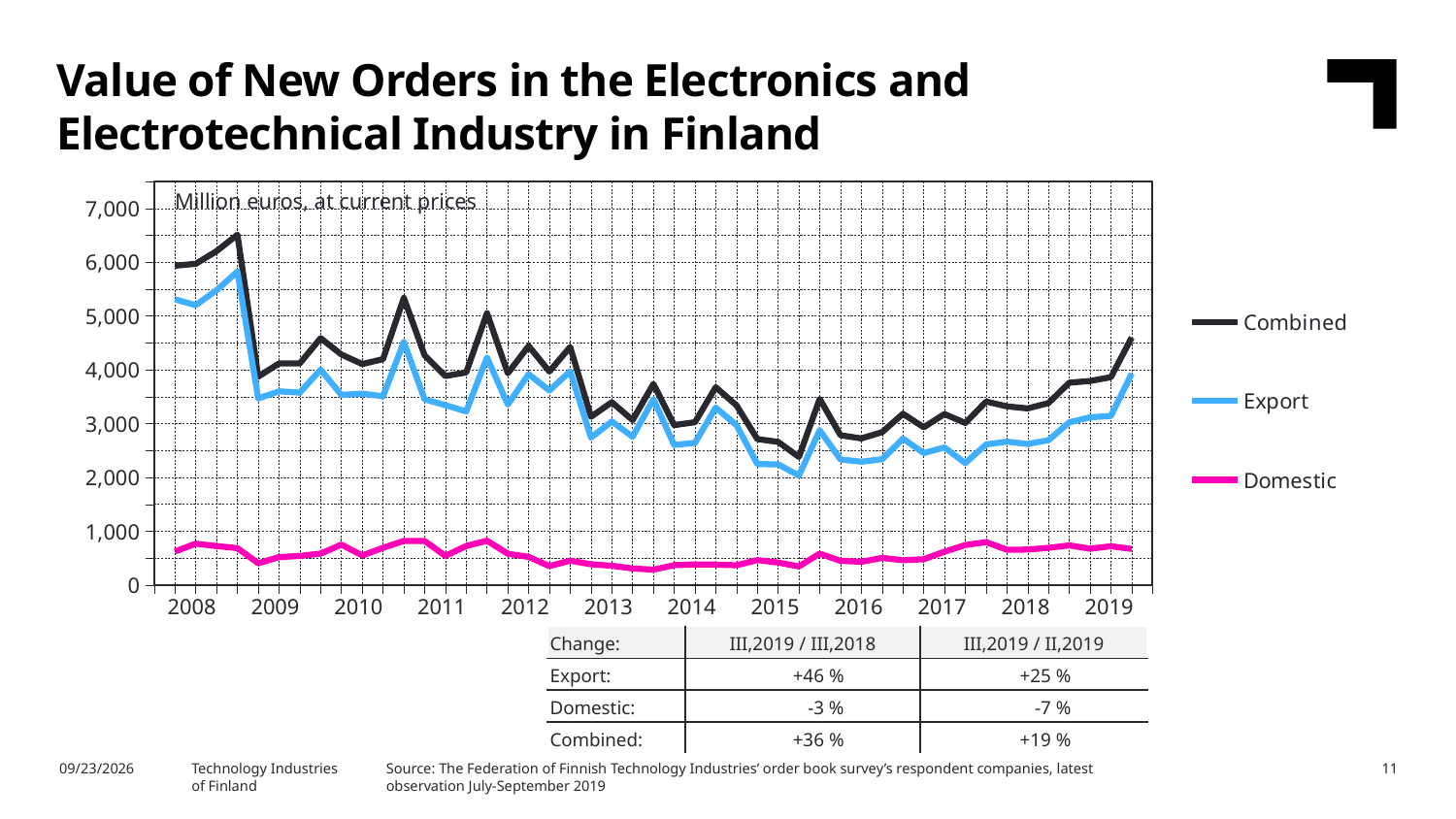
Which series has the highest values throughout the chart? Combined Is the peak value of the Combined series in 2008 greater or less than 6,000? greater What type of chart is shown on the slide? Line chart What unit is stated for the values on the chart? Million euros, at current prices What colour is the Export line in the chart? Blue Does the Combined series overall rise or fall between 2008 and 2015? fall Is the Domestic series ever greater than 1,000 million euros? No Is the value of the Export series at the start of 2008 greater or less than 5,000? greater How many series does the chart legend list? 3 Which series has the lowest values throughout the chart? Domestic